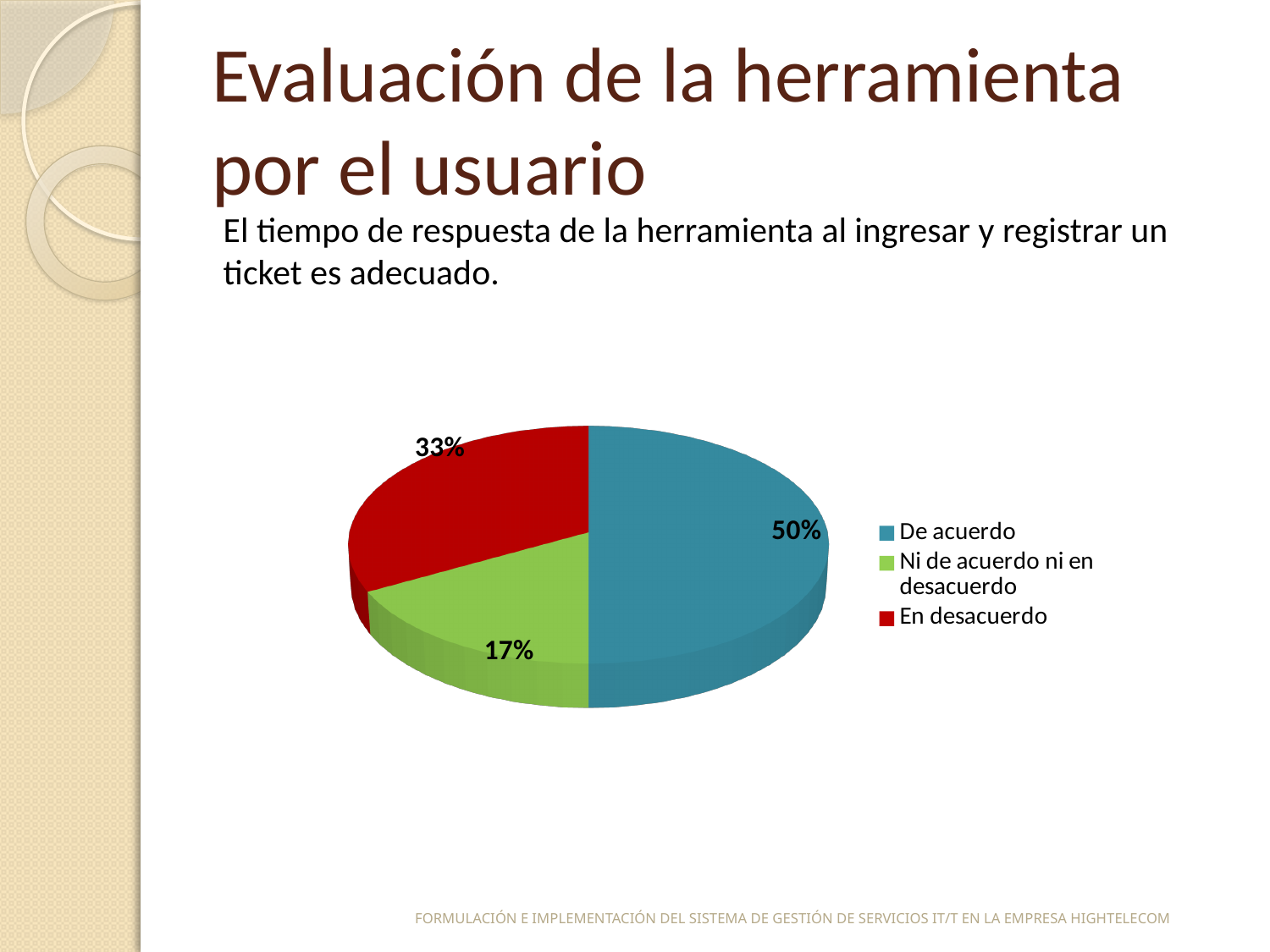
What colour is the slice for "En desacuerdo"? Red How many categories does the pie chart show? 3 What share of the pie does "Ni de acuerdo ni en desacuerdo" represent? 17% Which category has the smallest slice of the pie? Ni de acuerdo ni en desacuerdo What is the difference in percentage points between "De acuerdo" and "En desacuerdo"? 17 What share of the pie does "De acuerdo" represent? 50% What kind of chart is shown on the slide? Pie chart What is the difference in percentage points between "En desacuerdo" and "Ni de acuerdo ni en desacuerdo"? 16 Which legend entry is shown in blue? De acuerdo Which category has the largest slice of the pie? De acuerdo Which is larger, the slice for "En desacuerdo" or the slice for "Ni de acuerdo ni en desacuerdo"? En desacuerdo What share of the pie does "En desacuerdo" represent? 33%